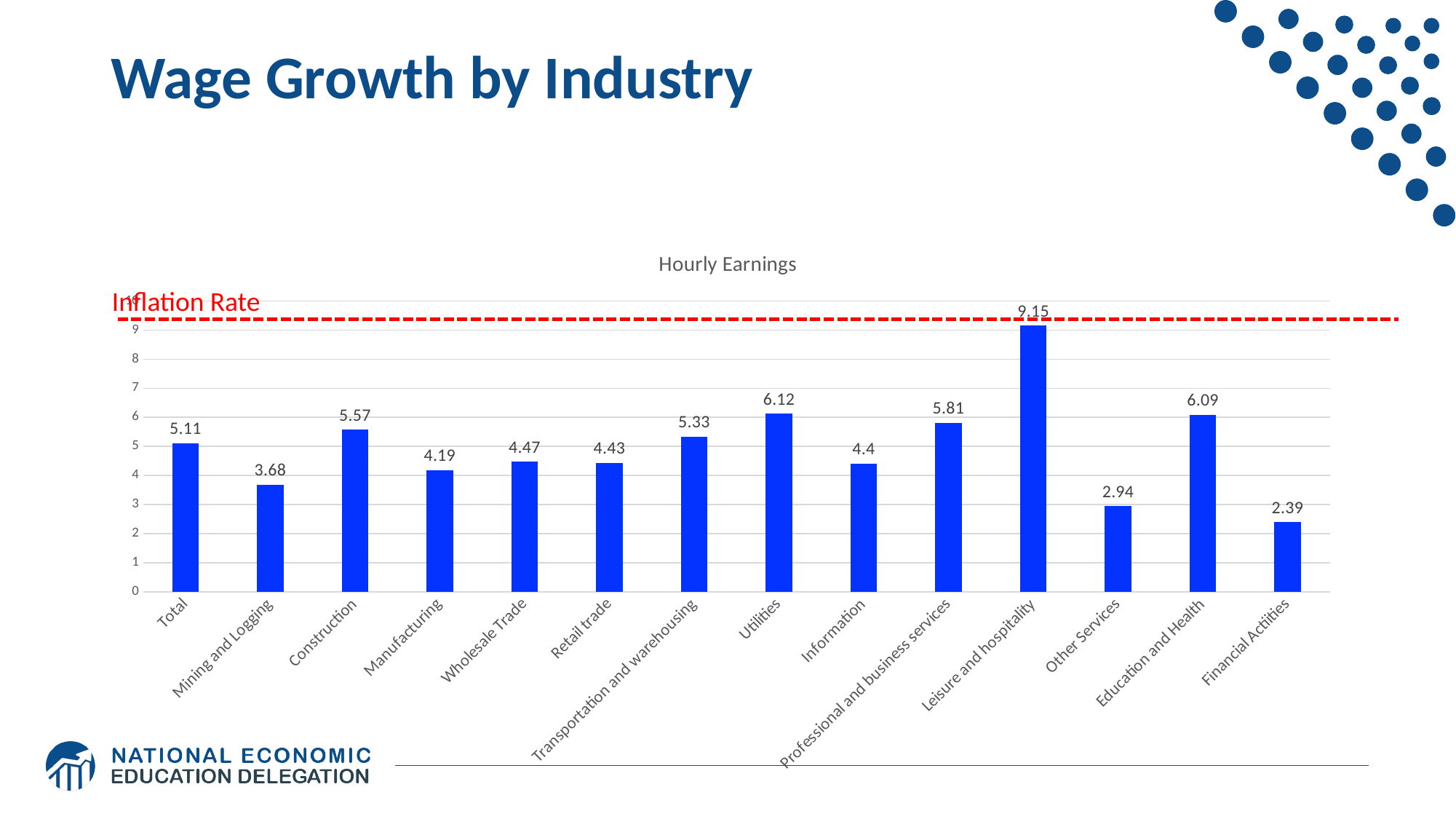
What is the title of the chart? Hourly Earnings What is the value for Mining and Logging? 3.68 What is the difference between the values for Utilities and Other Services? 3.18 How many categories are shown on the x axis? 14 What is the value for Leisure and hospitality? 9.15 What does the red dashed line on the chart represent? Inflation Rate Which category has the lowest value? Financial Actiities Is the value for Information greater or less than 5? less What is the value for Education and Health? 6.09 Which is larger, the value for Construction or the value for Manufacturing? Construction Which category has the highest value? Leisure and hospitality What kind of chart is shown on the slide? bar chart